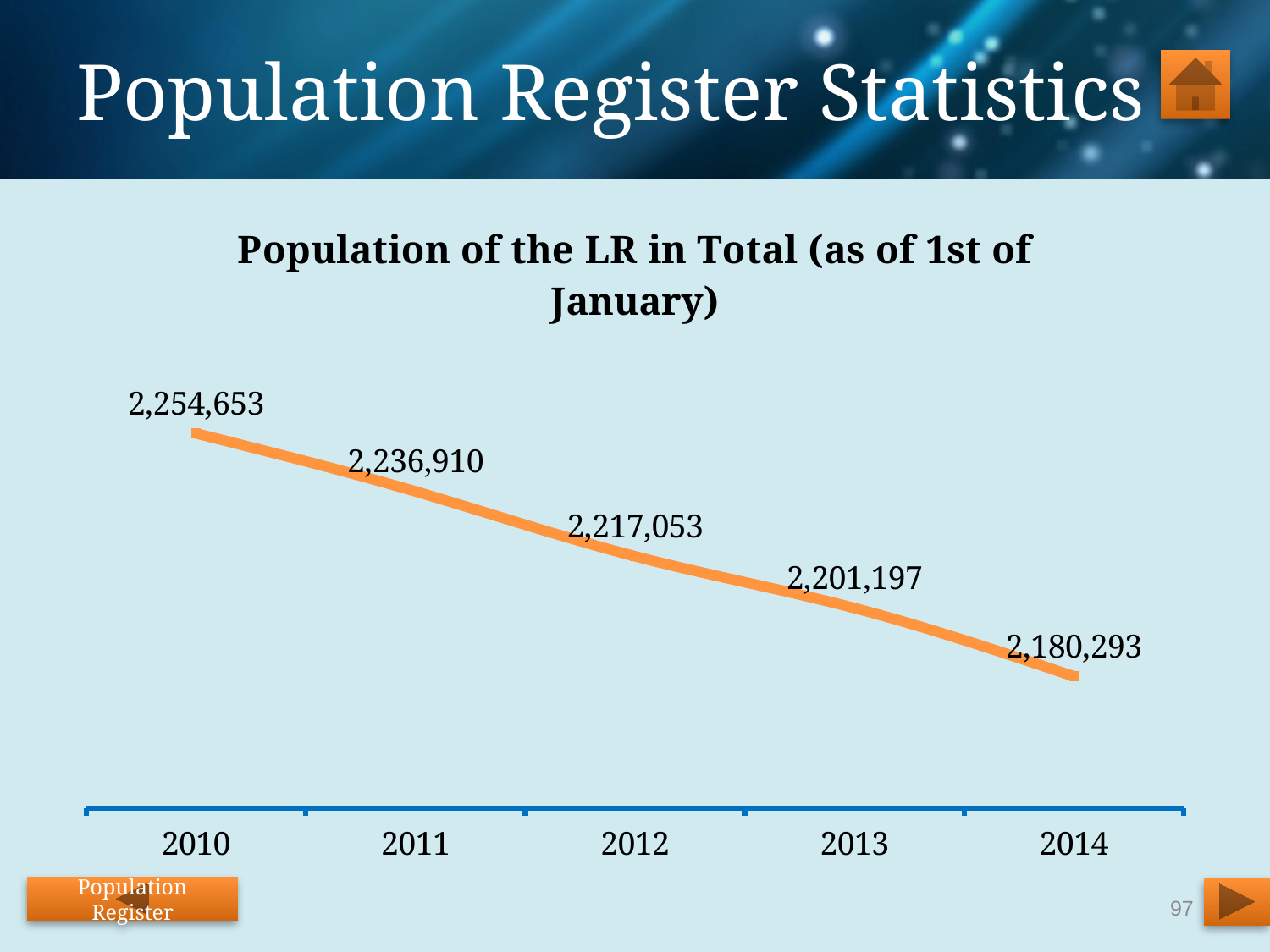
What is the population of the LR as of 1st January 2012? 2,217,053 What is the difference between the population in 2013 and in 2014? 20,904 Which year has the lowest population value on the chart? 2014 By how much did the population decrease from 2010 to 2014? 74,360 What is the population of the LR as of 1st January 2010? 2,254,653 Which year has the highest population value on the chart? 2010 What is the population of the LR as of 1st January 2014? 2,180,293 Does the population rise or fall from 2010 to 2014? Fall What kind of chart is shown on the slide? Line chart What is the population of the LR as of 1st January 2013? 2,201,197 How many years are plotted on the chart? 5 Which is larger, the population in 2011 or in 2012? 2011